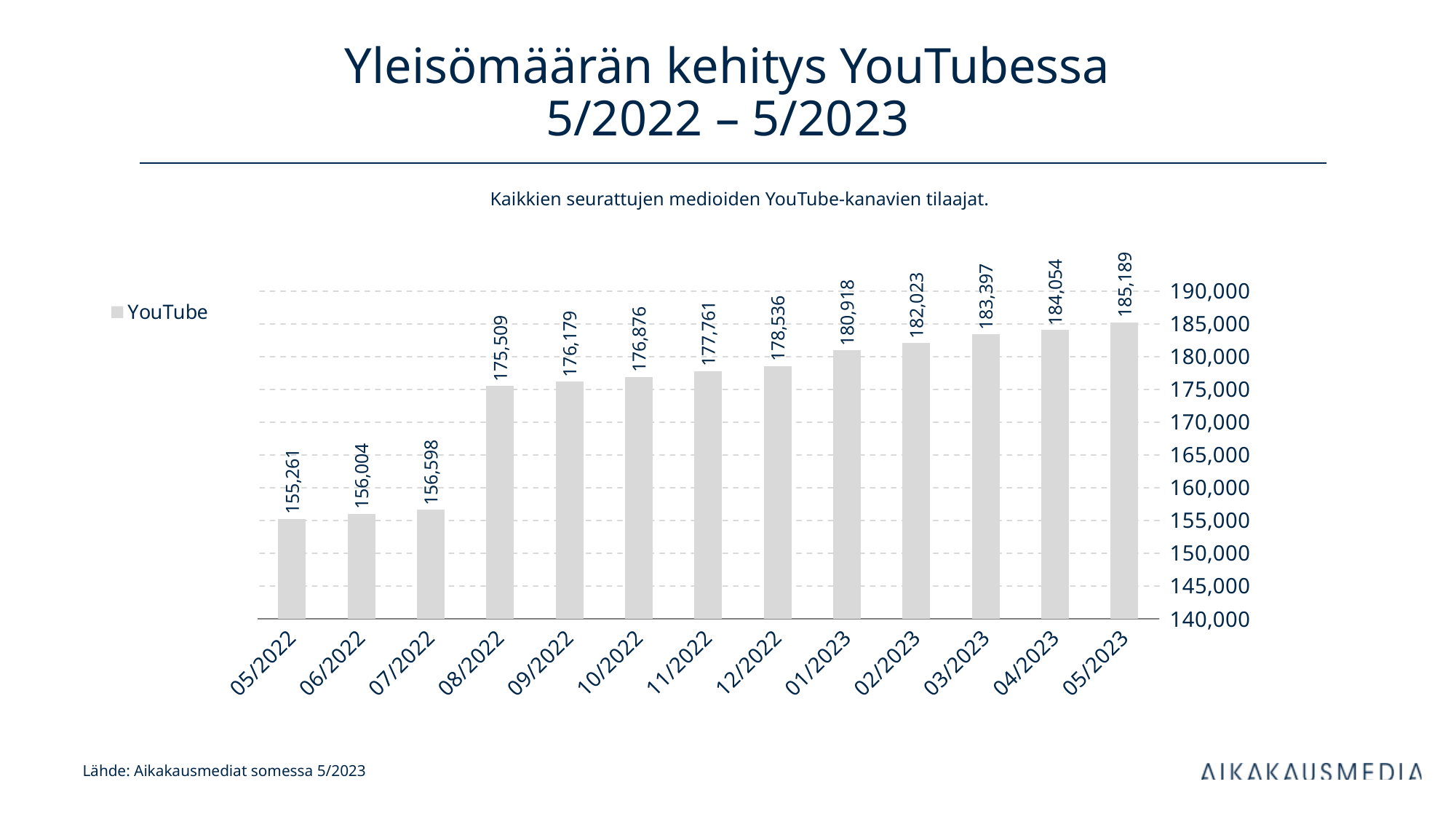
Which month has the lowest value? 05/2022 Is the value for 11/2022 greater or less than 175,000? greater What is the value for 08/2022? 175,509 What is the value for 01/2023? 180,918 Which month has the highest value? 05/2023 How many months are shown on the x axis? 13 Which is larger, the value for 12/2022 or the value for 02/2023? 02/2023 What is the value for 05/2022? 155,261 What is the difference between the values for 08/2022 and 07/2022? 18,911 What kind of chart is shown on the slide? bar chart What is the difference between the values for 05/2023 and 05/2022? 29,928 Do the values rise or fall from 05/2022 to 05/2023? rise